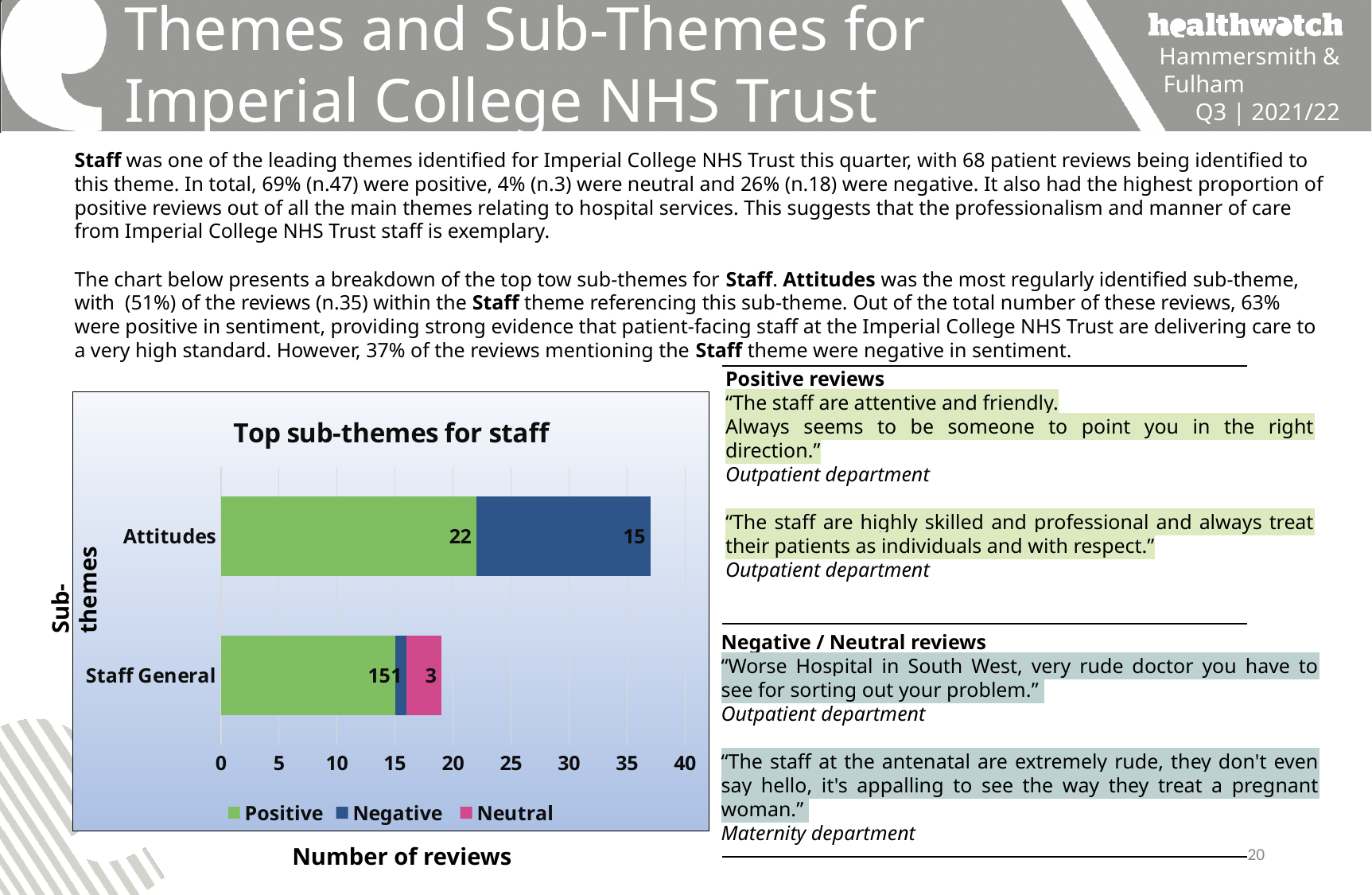
How many positive reviews are shown for Staff General? 15 How many series does the legend of the 'Top sub-themes for staff' chart list? 3 How many positive reviews are shown for Attitudes? 22 How many negative reviews are shown for Attitudes? 15 What kind of chart is 'Top sub-themes for staff'? bar chart How many neutral reviews are shown for Staff General? 3 What is the total number of reviews in the Attitudes bar? 37 What is the difference between the positive and negative review counts for Attitudes? 7 Which sub-theme has the highest total number of reviews? Attitudes What is the title of the horizontal axis of the chart? Number of reviews How many sub-themes are shown in the 'Top sub-themes for staff' chart? 2 Which sub-theme has more positive reviews, Attitudes or Staff General? Attitudes